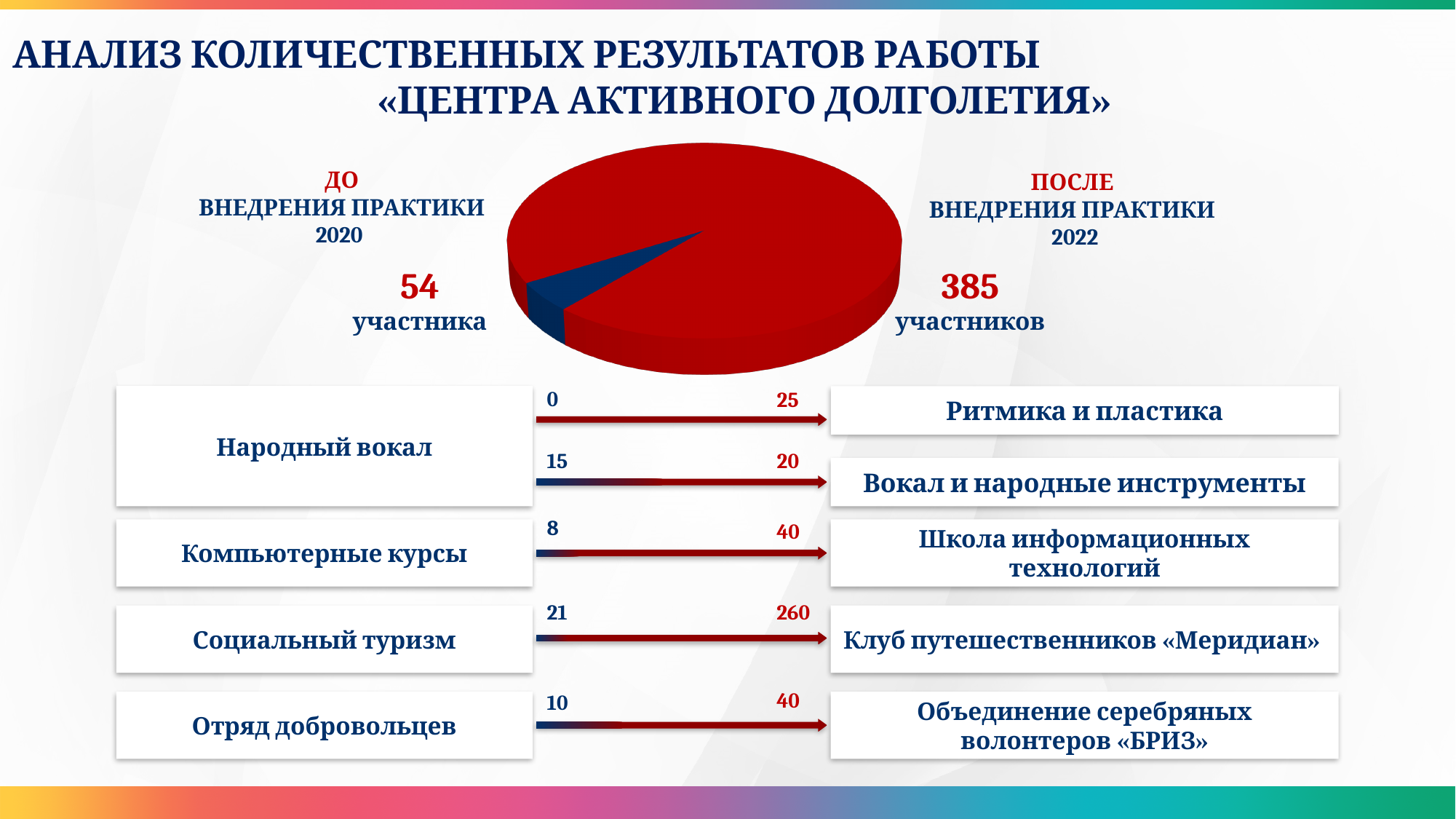
In the pie chart, how many participants were there after the practice was introduced (2022)? 385 How many slices does the pie chart have? 2 In the pie chart, how many participants were there before the practice was introduced (2020)? 54 In the pie chart, which slice is the smallest? 2020 (до внедрения практики), 54 участника In the pie chart, which year has the larger slice, 2020 or 2022? 2022 What kind of chart is shown at the top of the slide? Pie chart What colour is the slice representing 2022 (после внедрения практики) in the pie chart? Red What is the difference between the number of participants in 2022 and in 2020 shown on the pie chart? 331 In the arrow diagram below the pie chart, what value is shown at the right end of the arrow leading to Клуб путешественников «Меридиан»? 260 In the arrow diagram below the pie chart, what value is shown at the right end of the arrow leading to Школа информационных технологий? 40 What colour is the slice representing 2020 (до внедрения практики) in the pie chart? Dark blue In the arrow diagram below the pie chart, what value is shown for Социальный туризм before the practice (left end of the arrow)? 21